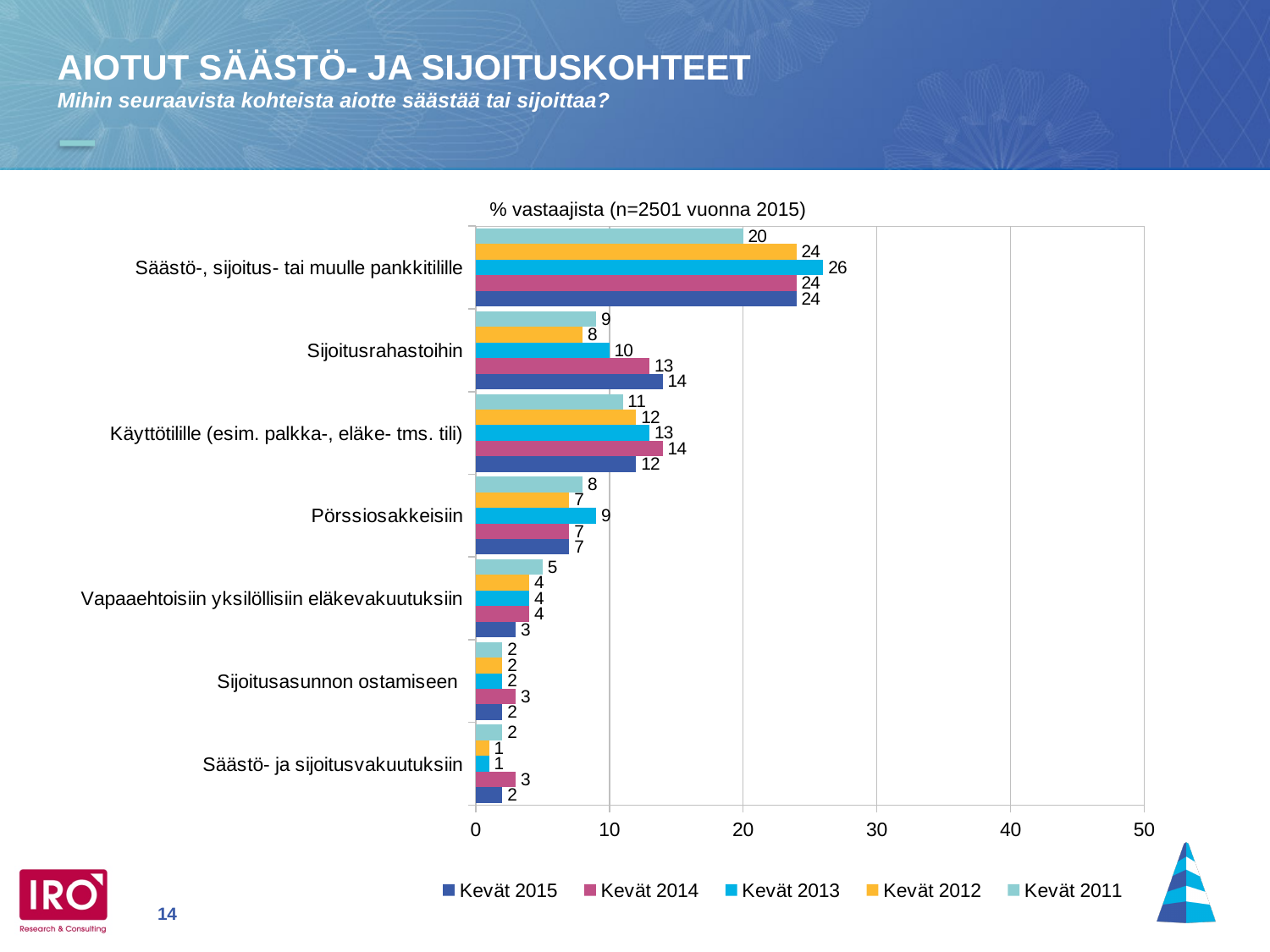
What kind of chart is shown on the slide? bar chart Which series has the lowest value in the category "Säästö-, sijoitus- tai muulle pankkitilille"? Kevät 2011 What is the value for Kevät 2011 in the category "Käyttötilille (esim. palkka-, eläke- tms. tili)"? 11 What is the value for Kevät 2013 in the category "Säästö-, sijoitus- tai muulle pankkitilille"? 26 What is the title printed above the chart? % vastaajista (n=2501 vuonna 2015) How many categories are shown on the chart? 7 Which category has the highest value for Kevät 2015? Säästö-, sijoitus- tai muulle pankkitilille What is the difference between the Kevät 2015 and Kevät 2011 values for "Sijoitusrahastoihin"? 5 What is the value for Kevät 2015 in the category "Sijoitusrahastoihin"? 14 Which is larger for "Pörssiosakkeisiin": the Kevät 2013 value or the Kevät 2012 value? Kevät 2013 Is the Kevät 2013 value for "Säästö-, sijoitus- tai muulle pankkitilille" greater or less than 20? greater How many series does the legend list? 5